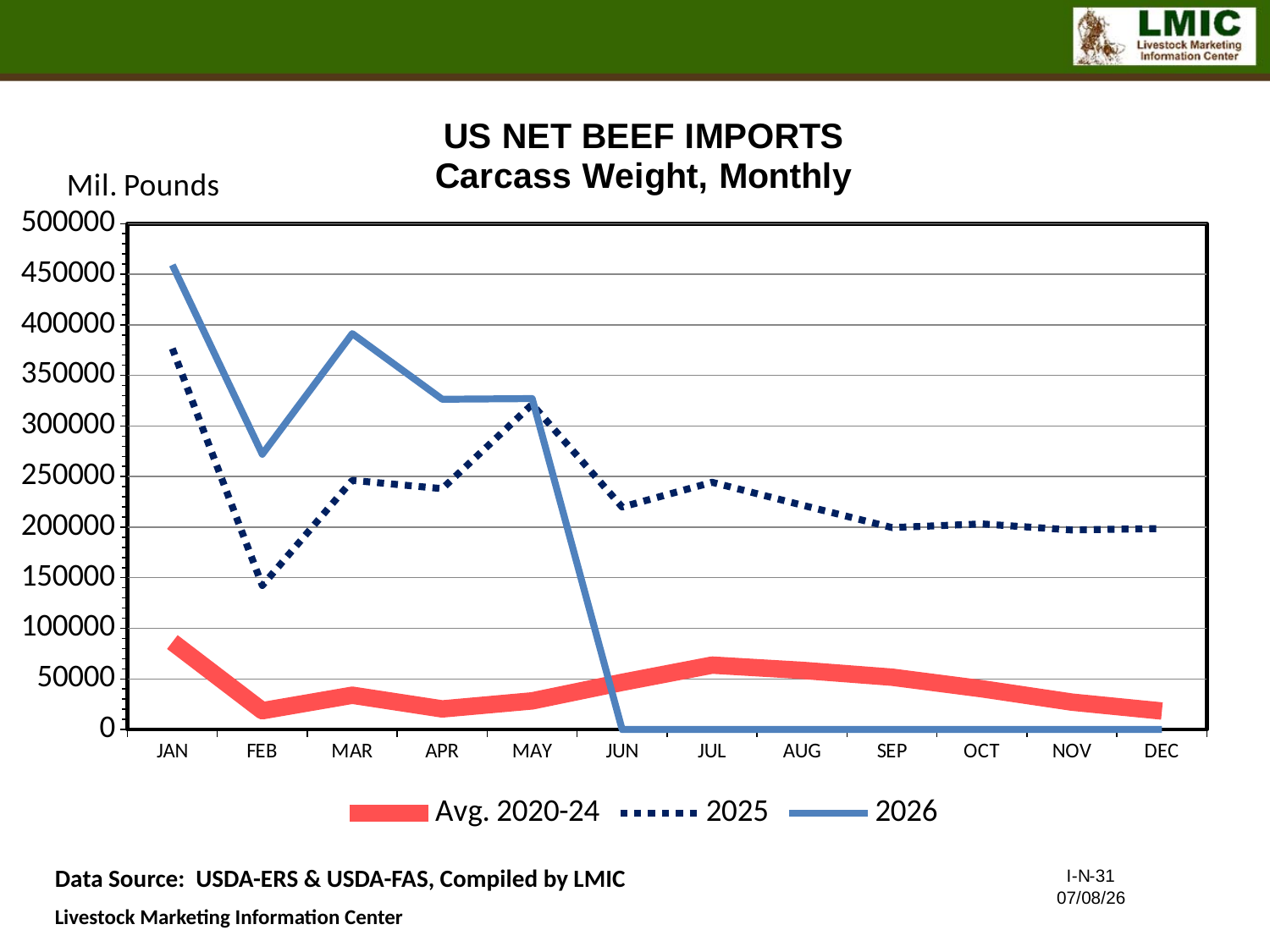
In which month is the 2025 series lowest? FEB How many series does the legend list? 3 How many months are shown along the x axis? 12 In which month is the 2026 series highest? JAN Which series are listed in the legend? Avg. 2020-24, 2025, 2026 In which month is the Avg. 2020-24 series highest? JAN Does the 2025 series rise or fall from JUL to DEC? fall Which is larger in MAR, the 2026 value or the 2025 value? 2026 Is the value for 2025 in FEB greater or less than 150000? less What unit label is shown above the y axis? Mil. Pounds What kind of chart is shown on the slide? line chart Is the value for 2026 in JAN greater or less than 400000? greater